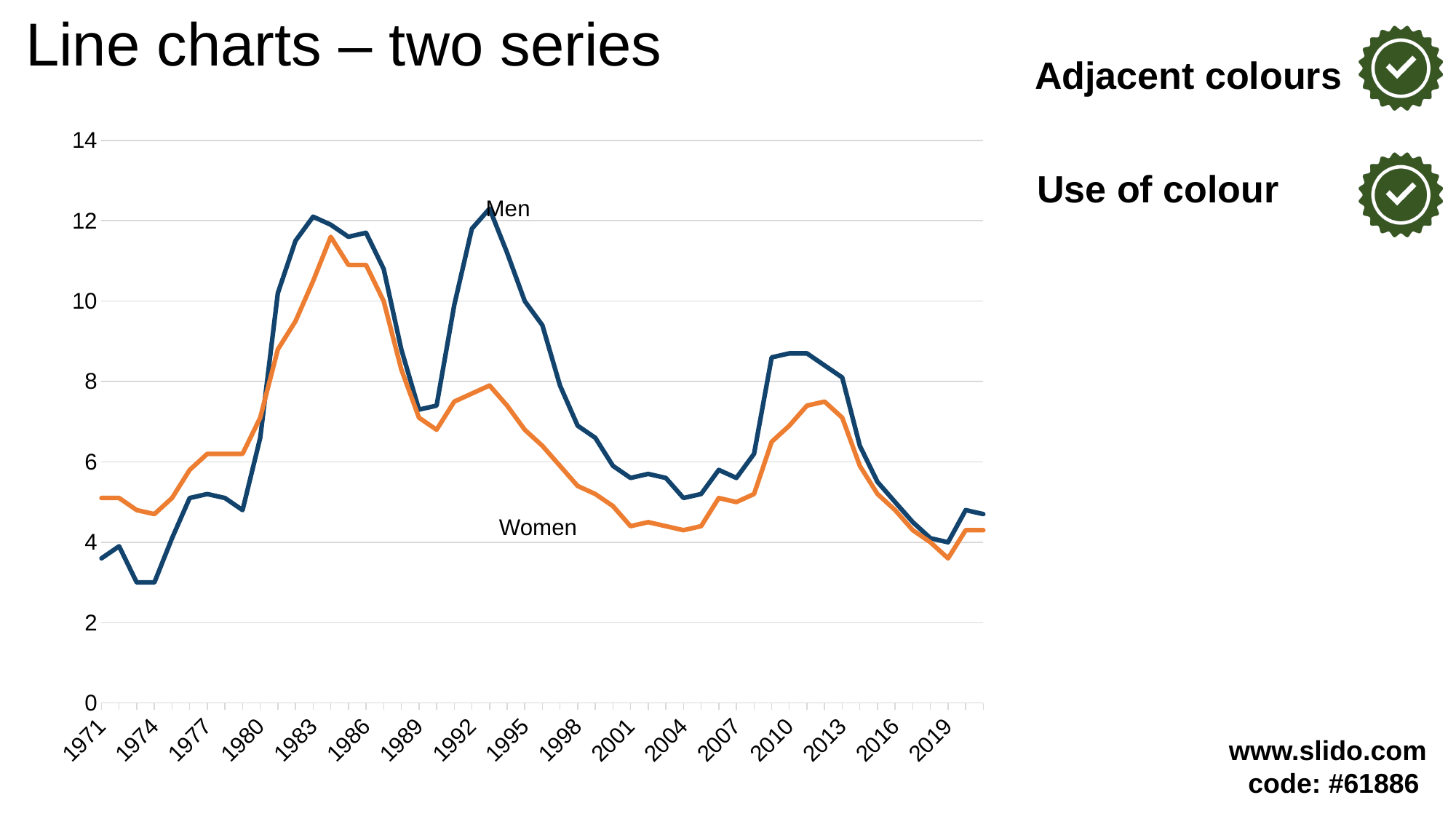
In 1974, which series has the higher value, Men or Women? Women Is the value for Men in 2010 greater or less than 8? greater Does the Men series rise or fall between 1980 and 1983? rise Is the value for Women in 1974 greater or less than 6? less What kind of chart is shown on the slide? line chart In 1992, which series has the higher value, Men or Women? Men Is the value for Men in 1974 greater or less than 4? less What are the names of the two series plotted on the chart? Men and Women How many series are plotted on the chart? 2 What is the title of the slide containing the chart? Line charts – two series